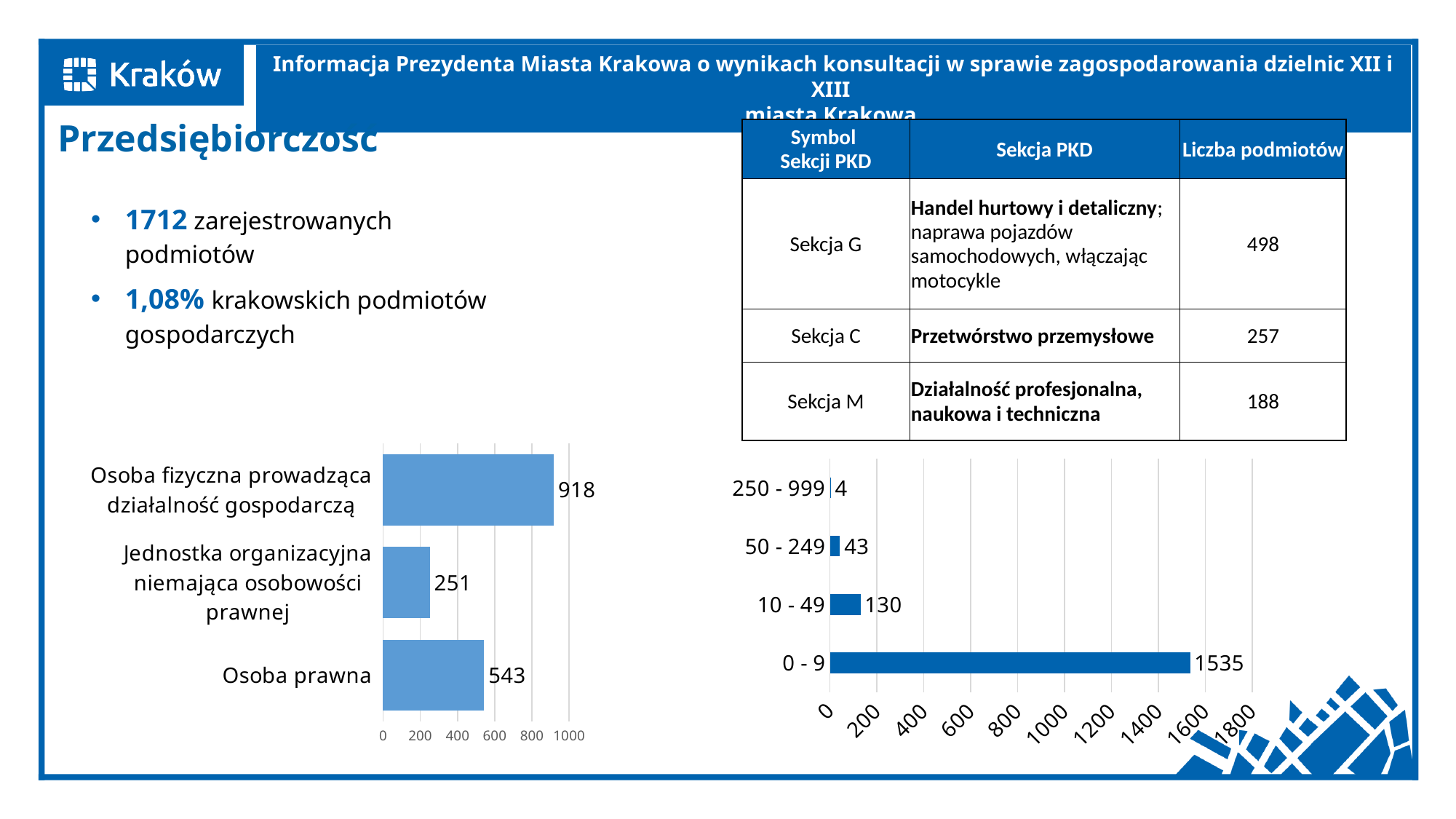
In the bar chart on the right of the slide, how many categories are shown? 4 In the bar chart on the left of the slide, what is the value for 'Jednostka organizacyjna niemająca osobowości prawnej'? 251 In the bar chart on the left of the slide, how many categories are shown? 3 In the bar chart on the right of the slide, which category has the lowest value? 250 - 999 In the bar chart on the left of the slide, which category has the highest value? Osoba fizyczna prowadząca działalność gospodarczą In the bar chart on the right of the slide, what is the value for the '10 - 49' category? 130 In the bar chart on the right of the slide, what is the value for the '0 - 9' category? 1535 What kind of chart is shown on the left of the slide? bar chart In the bar chart on the left of the slide, what is the difference between the values for 'Osoba fizyczna prowadząca działalność gospodarczą' and 'Osoba prawna'? 375 In the bar chart on the right of the slide, what is the difference between the values for '50 - 249' and '250 - 999'? 39 In the bar chart on the right of the slide, which is larger: the value for '50 - 249' or the value for '10 - 49'? 10 - 49 In the bar chart on the left of the slide, what is the value for 'Osoba prawna'? 543